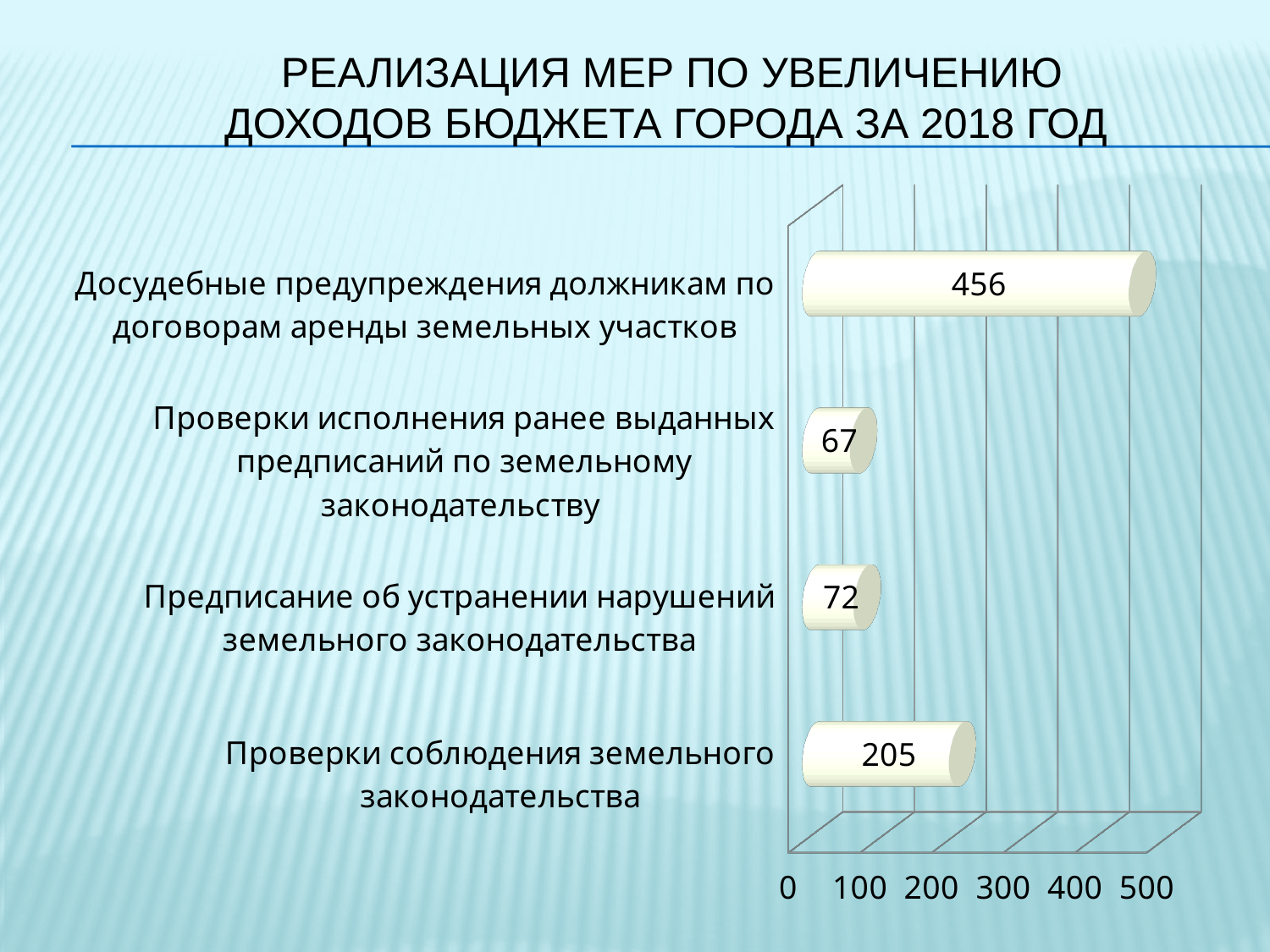
What is the value for "Предписание об устранении нарушений земельного законодательства"? 72 Which is larger: the value for "Проверки соблюдения земельного законодательства" or the value for "Предписание об устранении нарушений земельного законодательства"? Проверки соблюдения земельного законодательства Is the value for "Досудебные предупреждения должникам по договорам аренды земельных участков" greater or less than 400? greater What is the difference between the values for "Предписание об устранении нарушений земельного законодательства" and "Проверки исполнения ранее выданных предписаний по земельному законодательству"? 5 What is the difference between the values for "Досудебные предупреждения должникам по договорам аренды земельных участков" and "Проверки соблюдения земельного законодательства"? 251 What is the value for "Проверки соблюдения земельного законодательства"? 205 What kind of chart is shown on the slide? bar chart Which category has the highest value? Досудебные предупреждения должникам по договорам аренды земельных участков How many categories are shown in the chart? 4 What is the value for "Досудебные предупреждения должникам по договорам аренды земельных участков"? 456 What is the value for "Проверки исполнения ранее выданных предписаний по земельному законодательству"? 67 Which category has the lowest value? Проверки исполнения ранее выданных предписаний по земельному законодательству